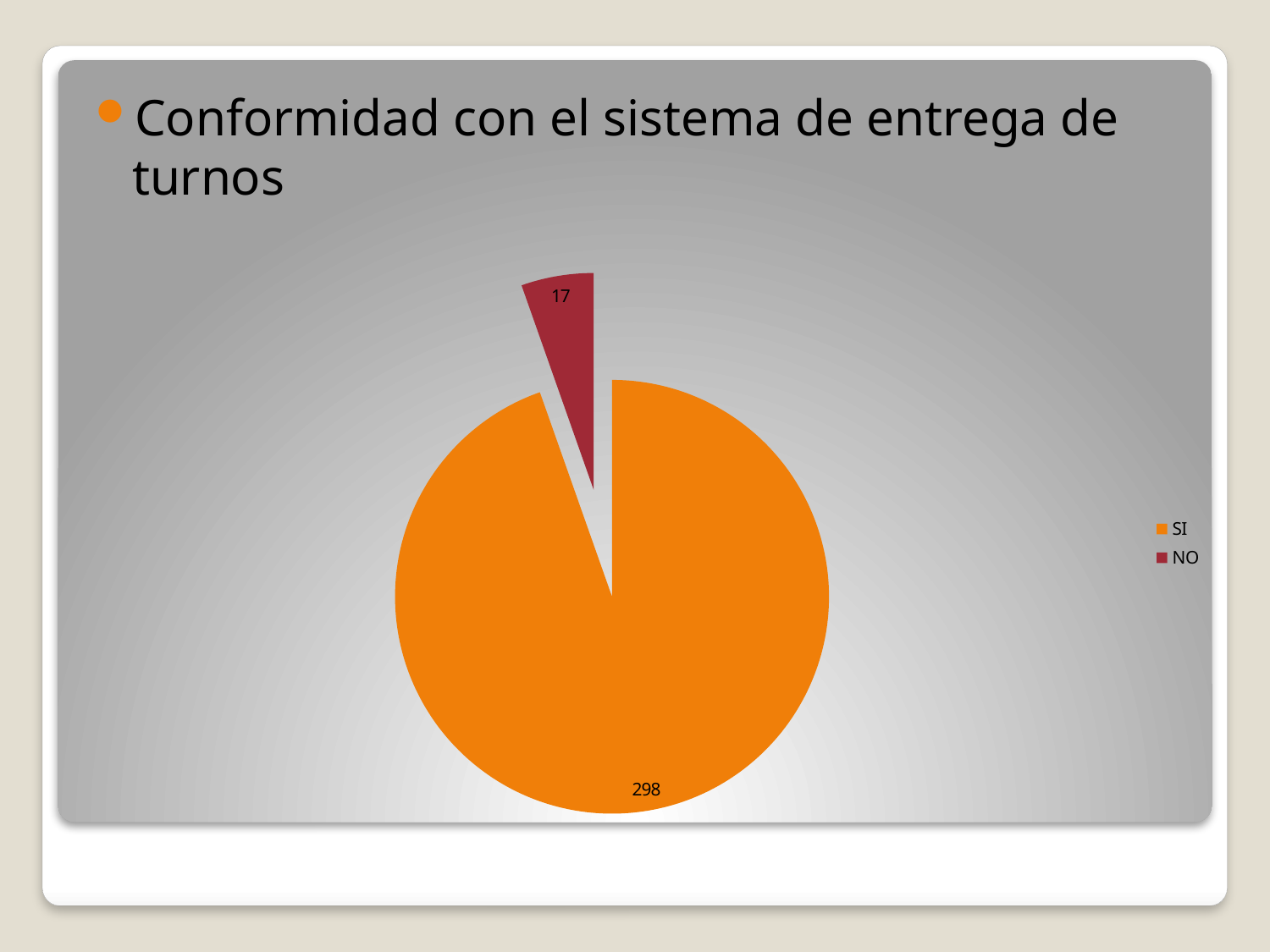
Which category has the largest slice in the pie chart? SI What is the difference between the values for SI and NO? 281 How many entries does the legend list? 2 Which category has the smallest slice in the pie chart? NO Which is larger, the value for SI or the value for NO? SI What is the value for NO in the pie chart? 17 What kind of chart is shown on the slide? Pie chart What colour is the SI slice in the pie chart? Orange How many slices does the pie chart have? 2 What is the total of all slices in the pie chart? 315 What is the value for SI in the pie chart? 298